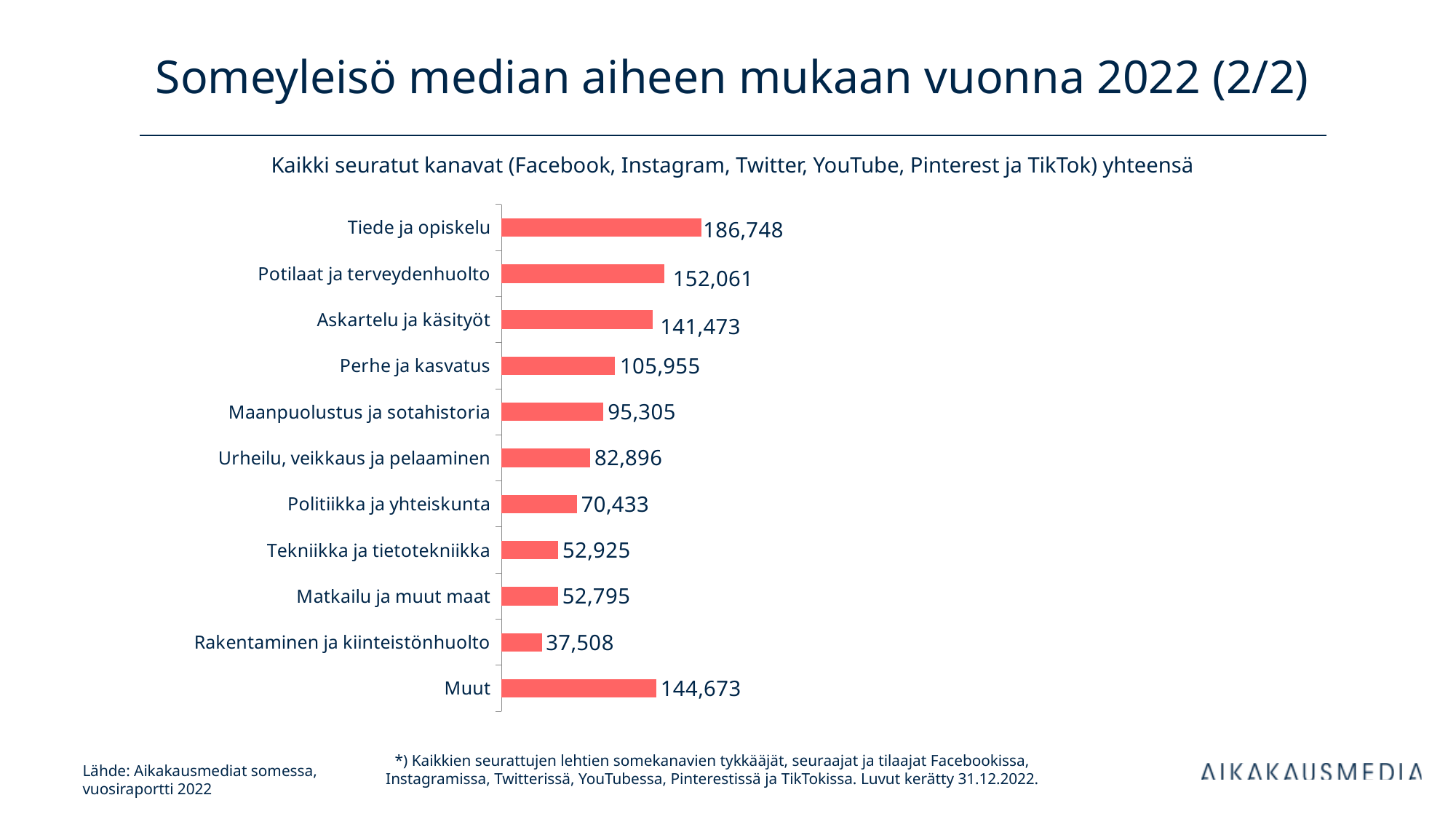
What is the value for Muut? 144,673 Which category has the lowest value? Rakentaminen ja kiinteistönhuolto How many categories are shown in the chart? 11 Which is larger, the value for Muut or the value for Askartelu ja käsityöt? Muut What is the difference between the values for Tiede ja opiskelu and Potilaat ja terveydenhuolto? 34,687 What is the value for Rakentaminen ja kiinteistönhuolto? 37,508 What is the value for Maanpuolustus ja sotahistoria? 95,305 What is the subtitle shown above the chart? Kaikki seuratut kanavat (Facebook, Instagram, Twitter, YouTube, Pinterest ja TikTok) yhteensä What is the value for Tiede ja opiskelu? 186,748 What kind of chart is shown on the slide? Bar chart Which category has the highest value? Tiede ja opiskelu What is the difference between the values for Tekniikka ja tietotekniikka and Matkailu ja muut maat? 130